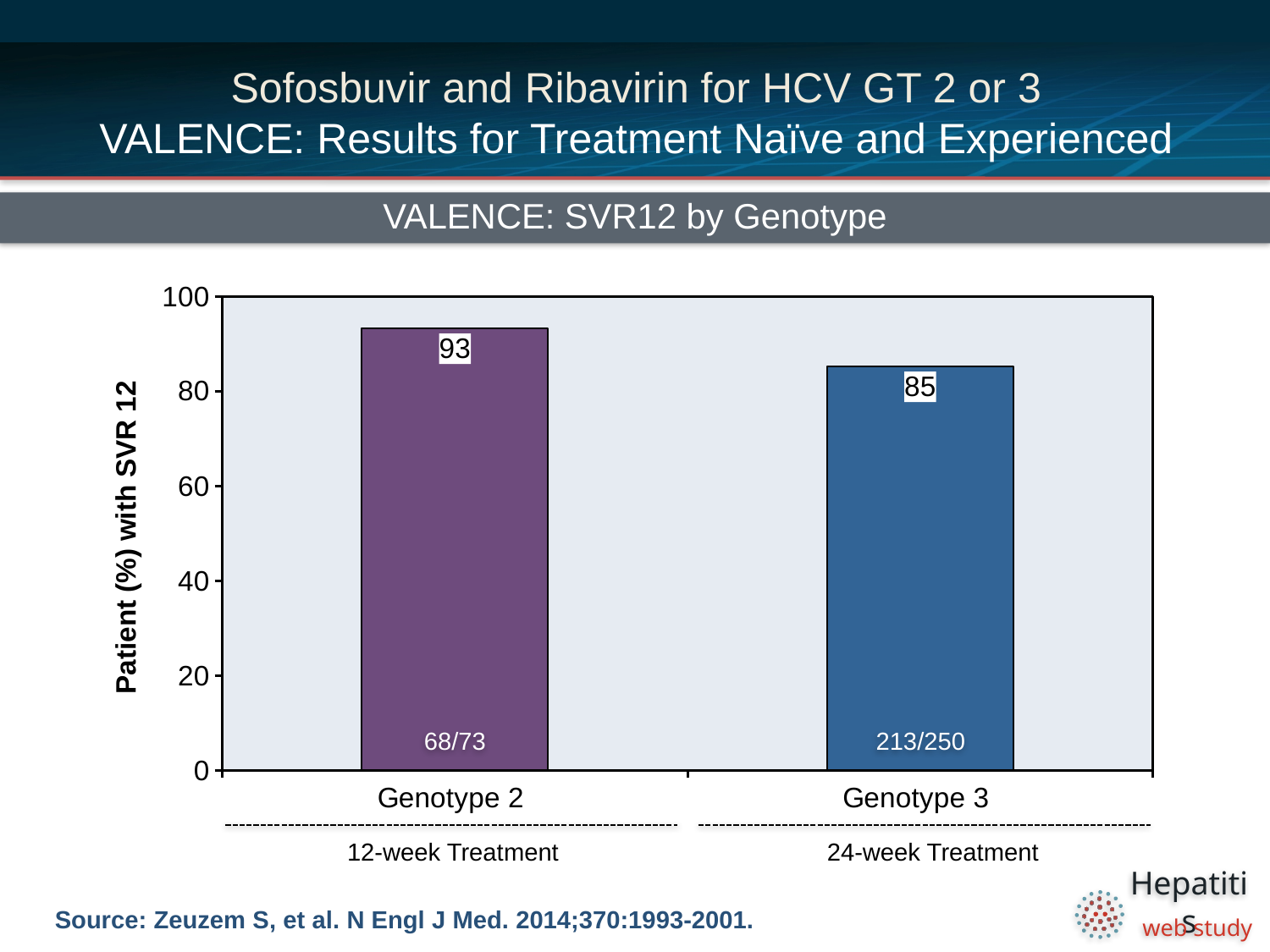
Which genotype has the highest SVR12 rate? Genotype 2 What patient fraction is printed on the Genotype 2 bar? 68/73 What patient fraction is printed on the Genotype 3 bar? 213/250 Which genotype has the lowest SVR12 rate? Genotype 3 What is the SVR12 rate for Genotype 3? 85 What is the SVR12 rate for Genotype 2? 93 What is the title of the chart? VALENCE: SVR12 by Genotype What kind of chart is shown on the slide? Bar chart How many genotype categories are shown in the chart? 2 Is the value for Genotype 3 greater or less than 80? greater What is the difference in SVR12 rate between Genotype 2 and Genotype 3? 8 Is the SVR12 rate higher for Genotype 2 or Genotype 3? Genotype 2